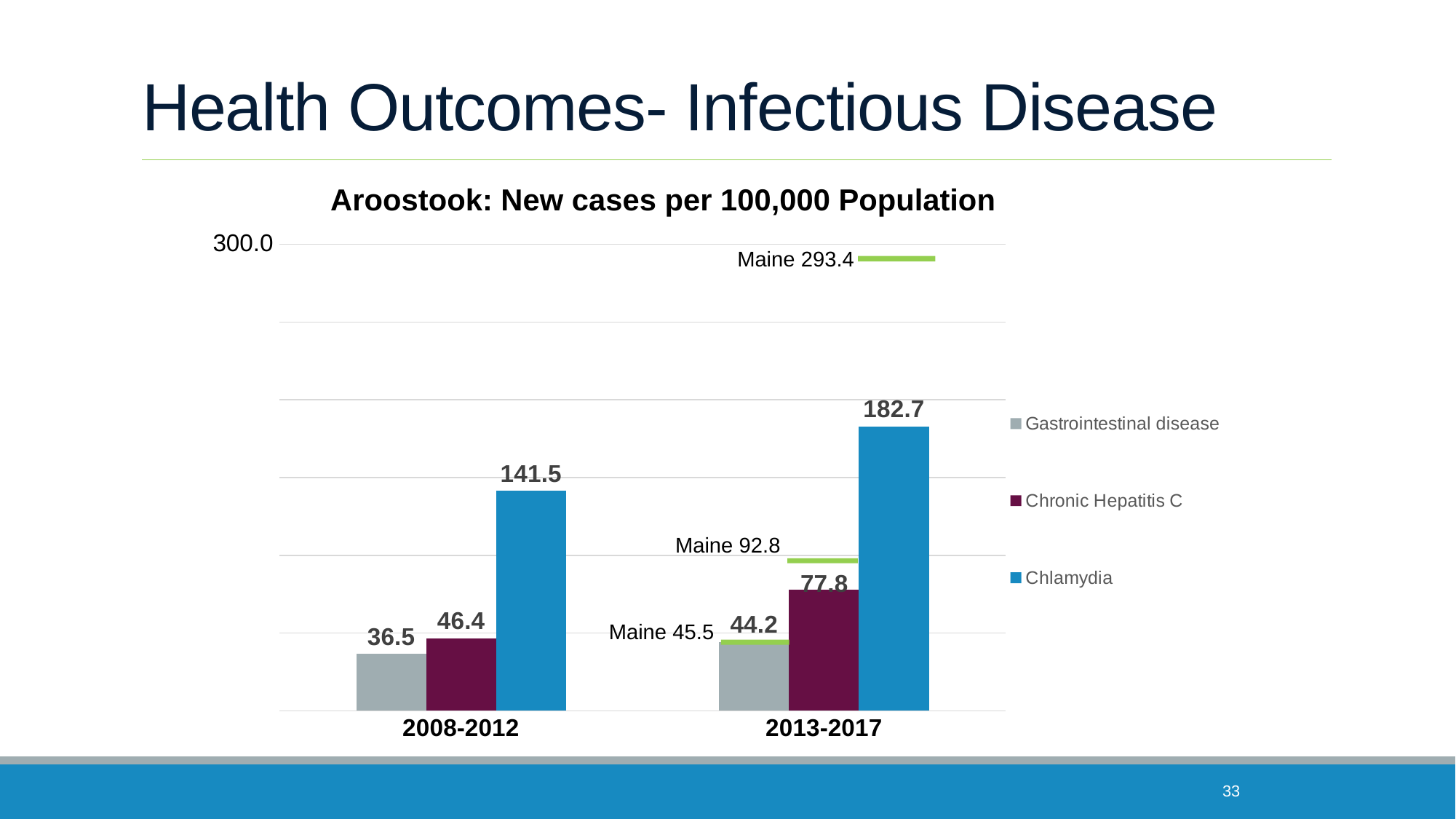
What is the Maine comparison value shown for Chlamydia in 2013-2017? 293.4 What is the Chronic Hepatitis C value for 2013-2017? 77.8 How many time periods are shown on the x axis? 2 What is the Chlamydia value for 2013-2017? 182.7 Does the Gastrointestinal disease value rise or fall from 2008-2012 to 2013-2017? rise Which series has the lowest value in 2013-2017? Gastrointestinal disease How many series does the legend list? 3 What is the Gastrointestinal disease value for 2008-2012? 36.5 What kind of chart is this? bar chart Which series has the highest value in 2008-2012? Chlamydia Which is larger: Chronic Hepatitis C in 2008-2012 or Chronic Hepatitis C in 2013-2017? 2013-2017 What is the difference between the Chlamydia values for 2013-2017 and 2008-2012? 41.2